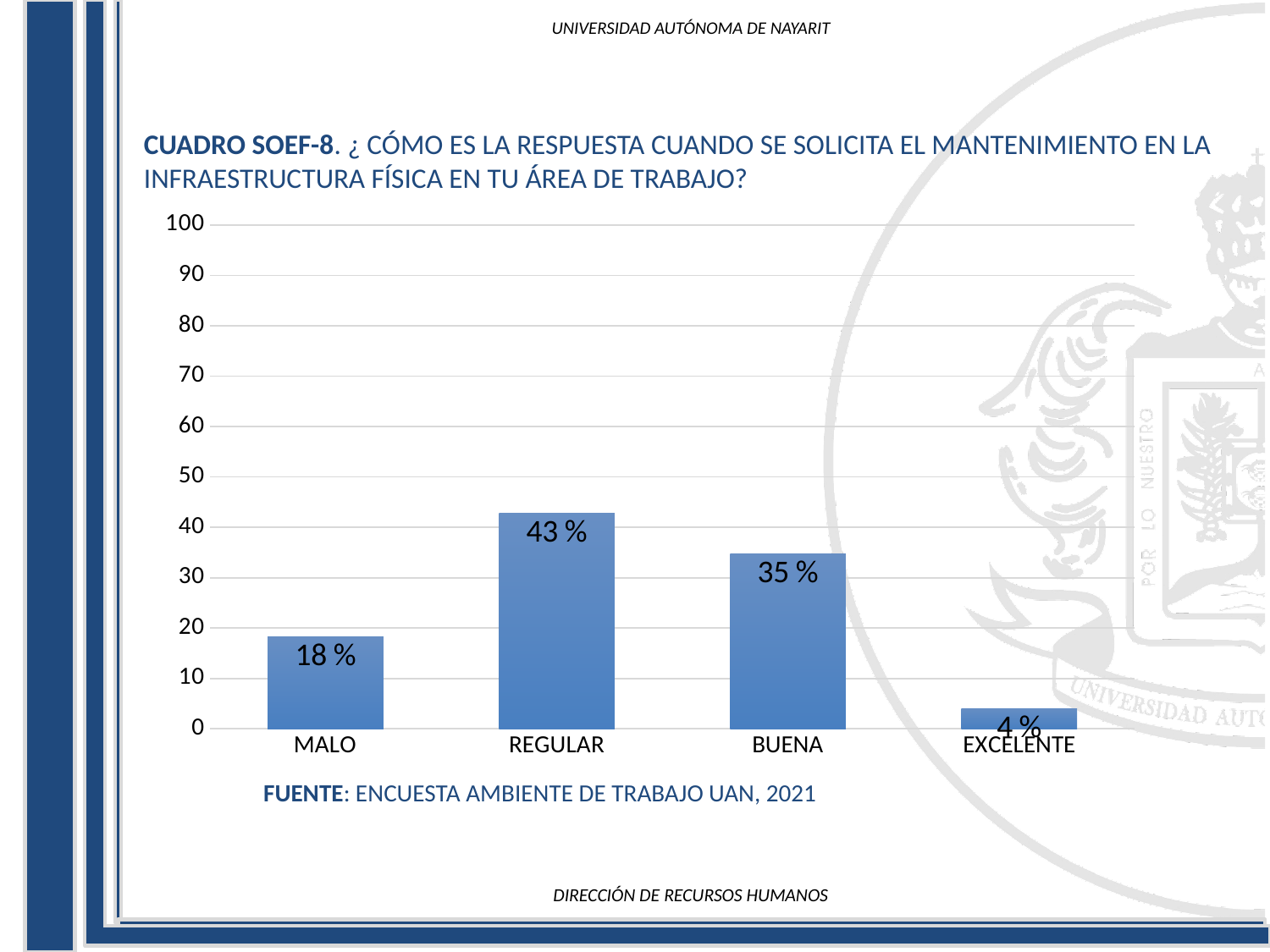
Which category has the lowest value? EXCELENTE What is the value for MALO? 18 % What kind of chart is shown on the slide? bar chart What source is cited below the chart? ENCUESTA AMBIENTE DE TRABAJO UAN, 2021 Which is larger, the value for MALO or the value for BUENA? BUENA What is the value for EXCELENTE? 4 % What is the value for REGULAR? 43 % Which category has the highest value? REGULAR What is the difference between the values for REGULAR and BUENA? 8 % What is the value for BUENA? 35 % Is the value for REGULAR greater or less than 40? greater How many categories are shown on the x axis? 4